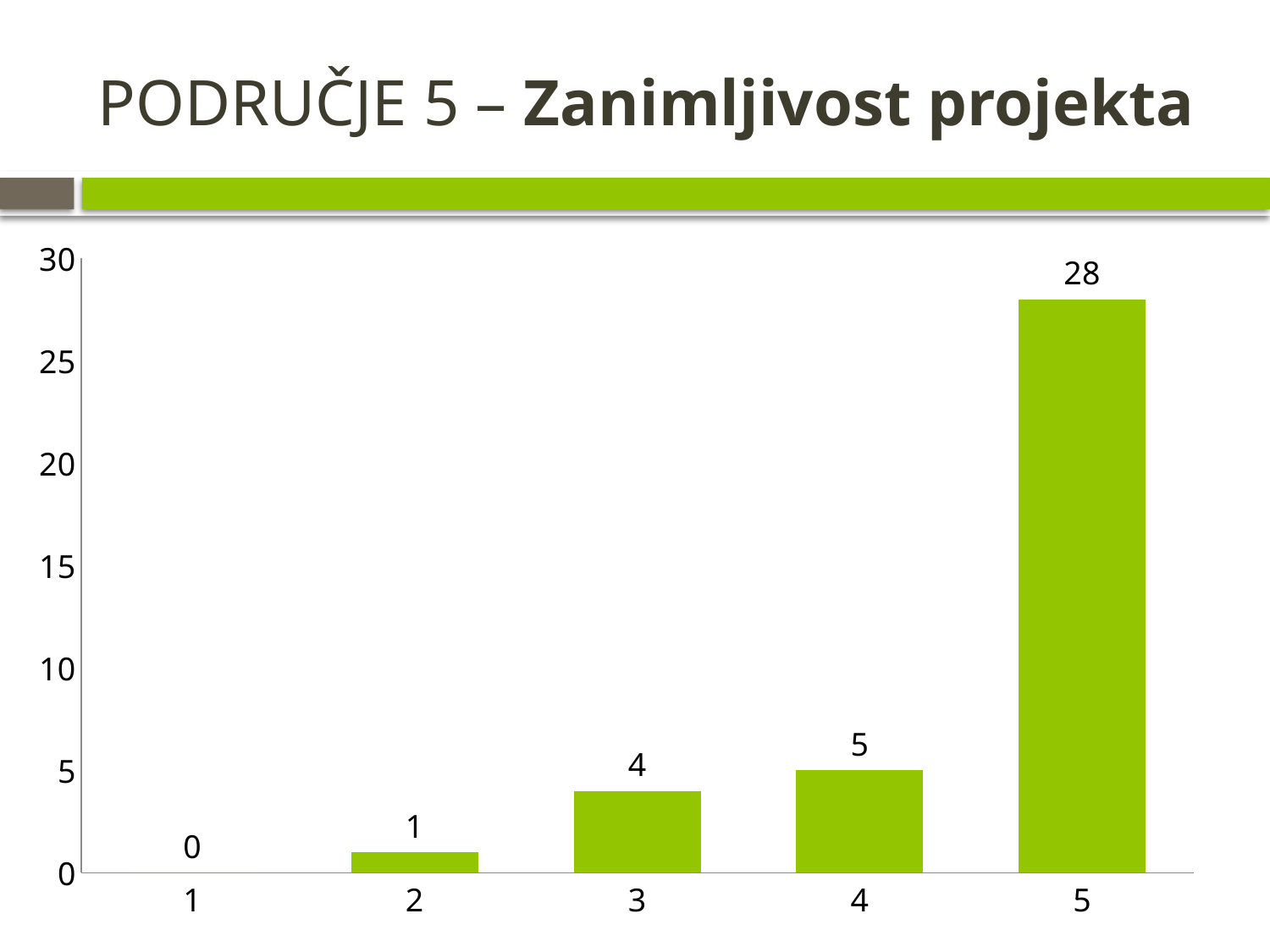
Is the value for category 5 greater or less than 25? greater What is the difference between the values for category 5 and category 4? 23 Do the values rise or fall from category 1 to category 5? rise What is the value for category 2? 1 Which category has the lowest value? 1 How many categories are shown on the x axis? 5 What is the value for category 5? 28 What is the value for category 3? 4 What kind of chart is shown on the slide? bar chart What is the value for category 1? 0 Which category has the highest value? 5 Which is larger, the value for category 3 or category 4? category 4